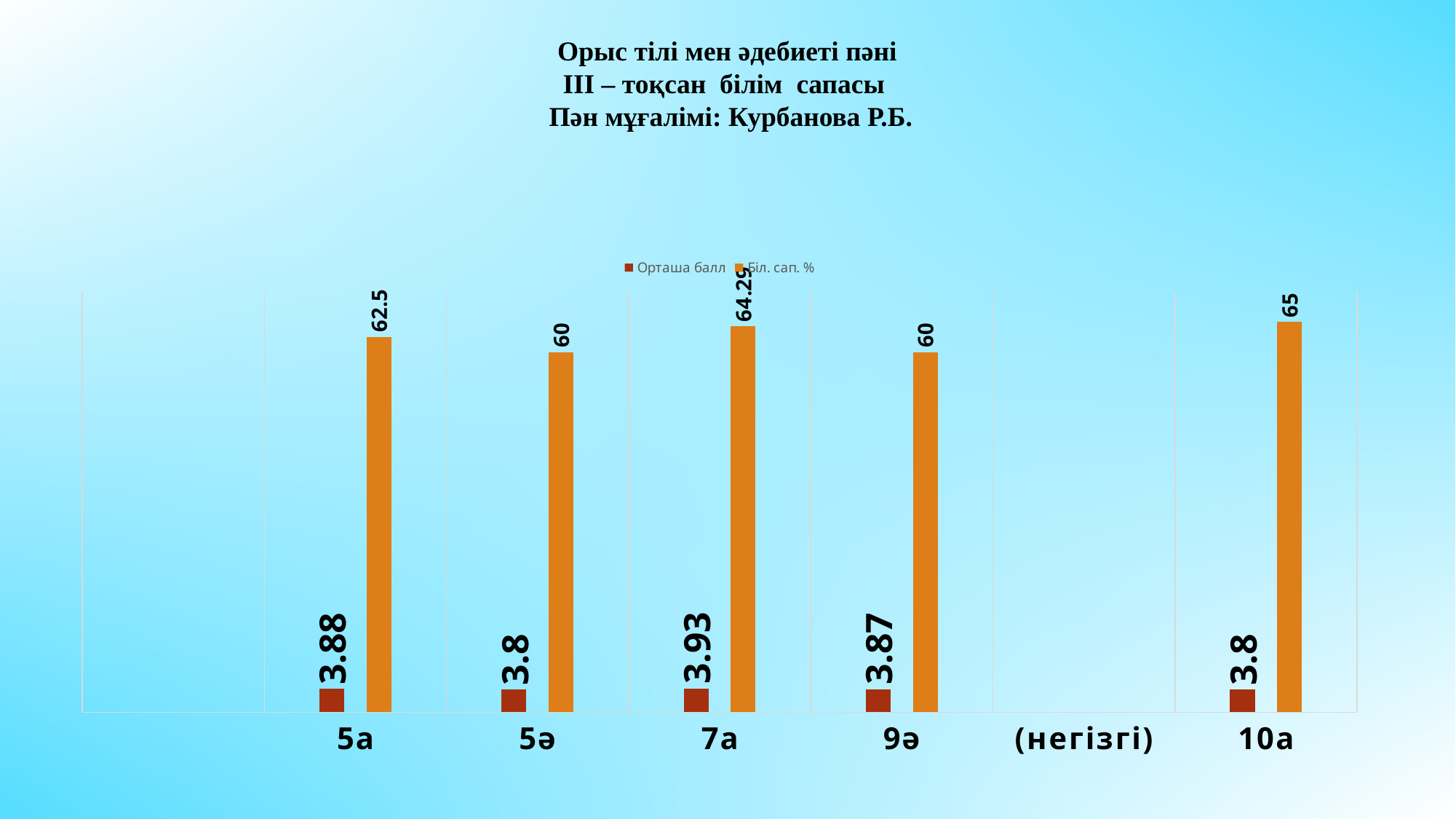
What is the Орташа балл value for 5а? 3.88 Which series is shown in orange in the legend? Біл. сап. % What is the Біл. сап. % value for 7а? 64.29 What is the Орташа балл value for 9ә? 3.87 What kind of chart is shown on the slide? bar chart What is the Біл. сап. % value for 10а? 65 How many categories on the x axis have bars plotted? 5 How many series does the legend list? 2 What is the difference between the Біл. сап. % values for 10а and 5а? 2.5 Which category has the highest Біл. сап. % value? 10а Which is larger, the Біл. сап. % value for 7а or for 9ә? 7а Which category has the highest Орташа балл value? 7а